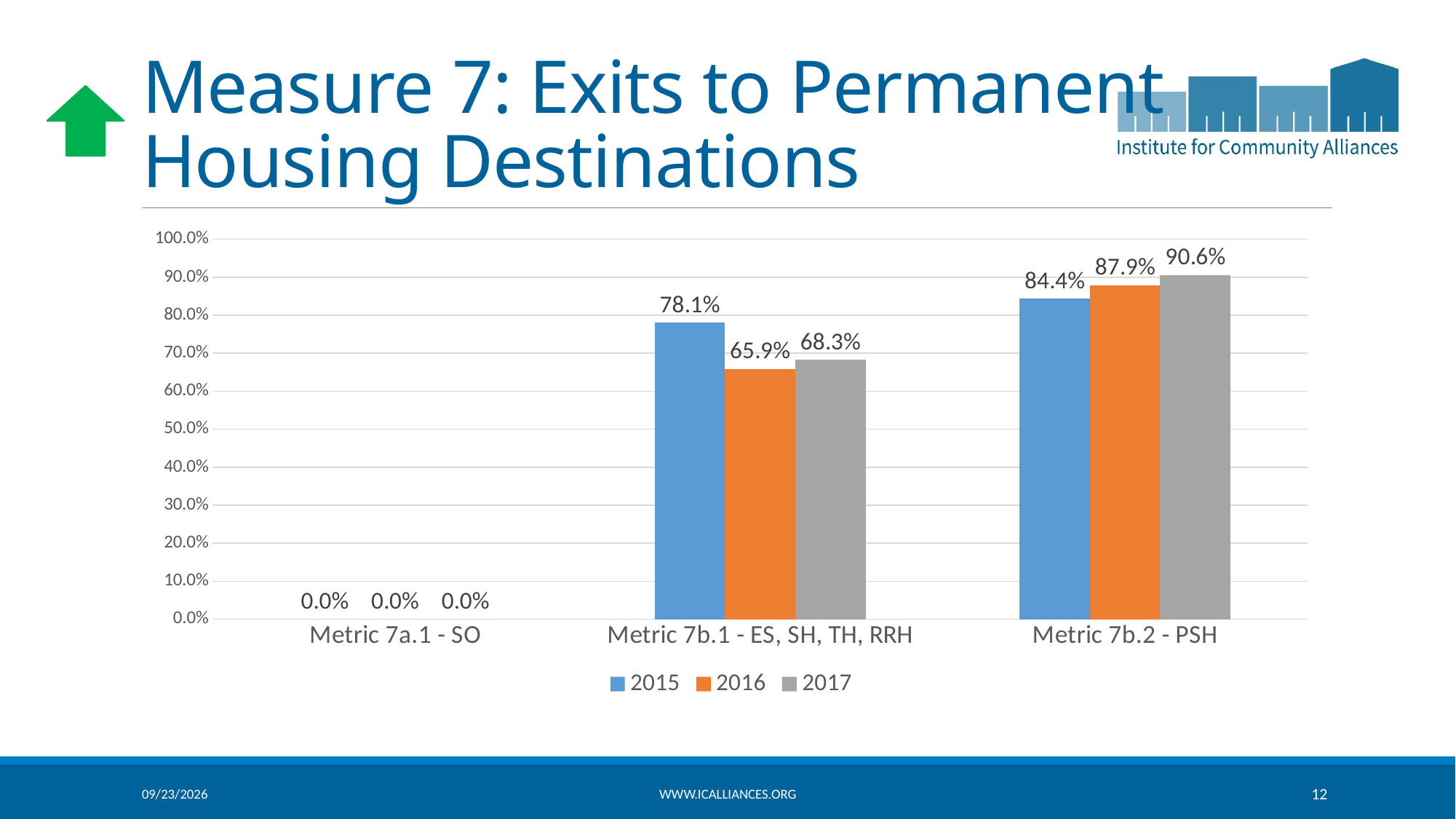
Which year has the lowest value for Metric 7b.1 - ES, SH, TH, RRH? 2016 How many series does the legend list? 3 What is the 2015 value for Metric 7b.1 - ES, SH, TH, RRH? 78.1% What kind of chart is shown on the slide? Bar chart How many metric categories are shown on the x axis? 3 What is the difference between the 2017 and 2015 values for Metric 7b.2 - PSH? 6.2% What is the 2015 value for Metric 7a.1 - SO? 0.0% What is the 2016 value for Metric 7b.1 - ES, SH, TH, RRH? 65.9% What is the 2017 value for Metric 7b.2 - PSH? 90.6% Which is larger: the 2017 value for Metric 7b.1 - ES, SH, TH, RRH or the 2015 value for Metric 7b.2 - PSH? 2015 value for Metric 7b.2 - PSH Which year has the highest value for Metric 7b.2 - PSH? 2017 Do the values for Metric 7b.2 - PSH rise or fall from 2015 to 2017? Rise